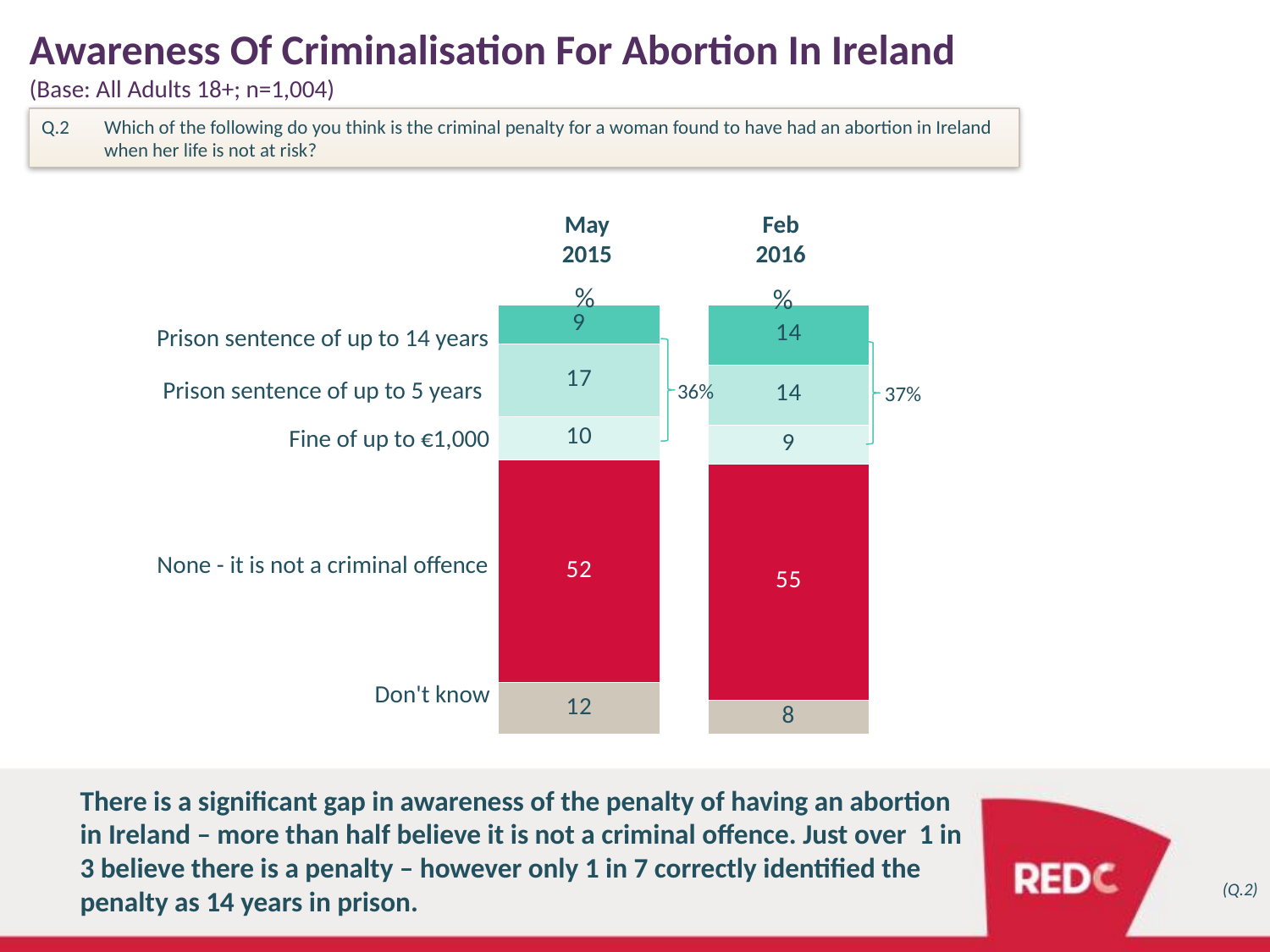
Which period has the larger value for "Prison sentence of up to 5 years", May 2015 or Feb 2016? May 2015 How many time periods (bars) does the chart compare? 2 Did the value for "None - it is not a criminal offence" rise or fall from May 2015 to Feb 2016? Rise What is the combined total shown for the three penalty categories (14 years, 5 years, fine) in May 2015? 36% What is the "Don't know" value for Feb 2016? 8 In May 2015, which response category has the lowest value? Prison sentence of up to 14 years What kind of chart is shown on the slide? Stacked bar chart What is the value for "Prison sentence of up to 14 years" in Feb 2016? 14 What percentage of respondents in May 2015 said "None - it is not a criminal offence"? 52 By how many points did the "Don't know" value fall from May 2015 to Feb 2016? 4 In Feb 2016, which response category has the highest value? None - it is not a criminal offence How many response categories are shown in the chart? 5